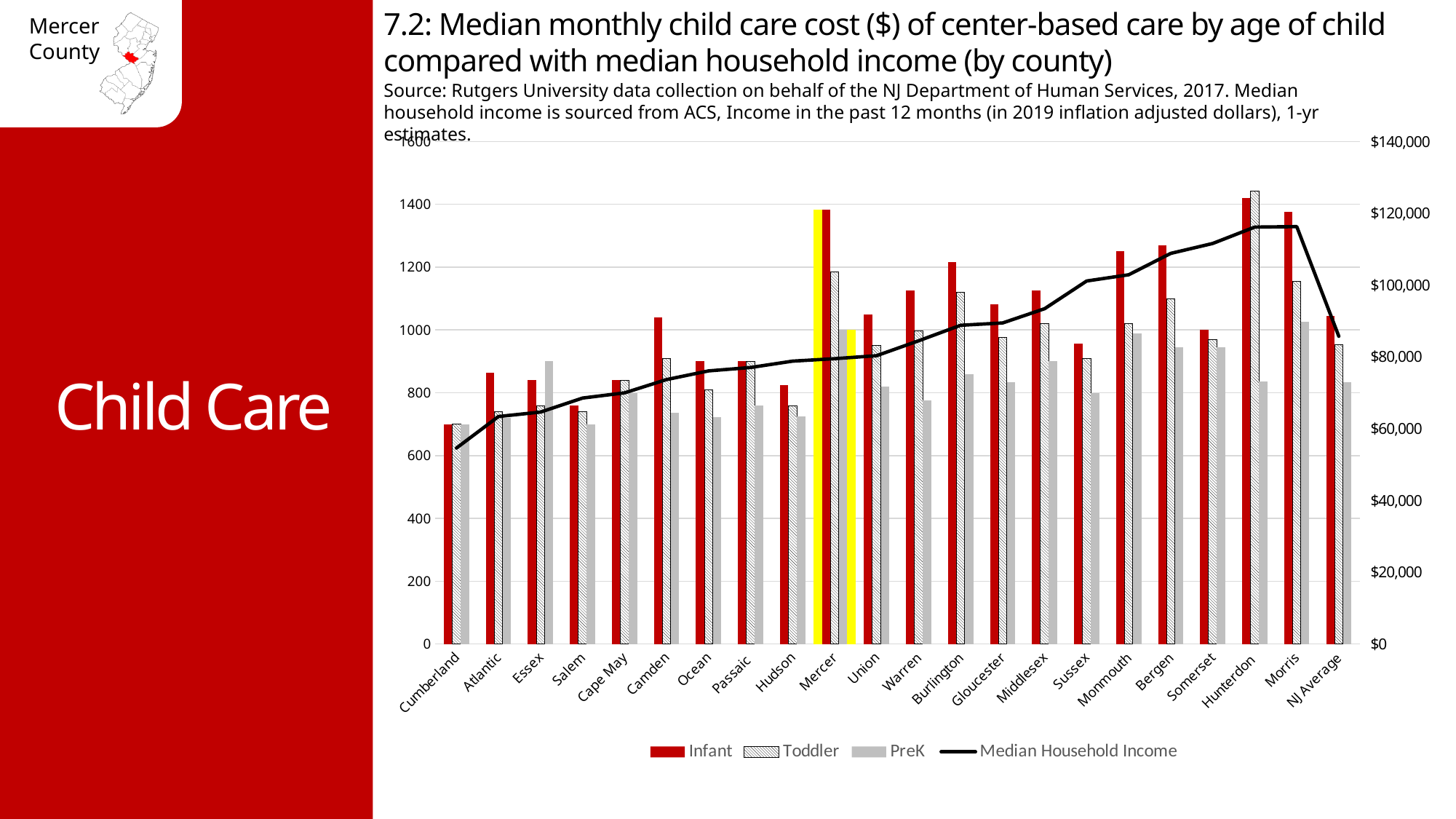
Which is larger, the Infant cost for Mercer or the Infant cost for Cumberland? Mercer Is the Infant cost for Mercer greater or less than 1200? greater Which county's bars are highlighted in yellow on the chart? Mercer Is the Infant cost for Cumberland greater or less than 800? less Which is larger for Hunterdon, the Toddler cost or the PreK cost? Toddler Is the Toddler cost for Hunterdon greater or less than 1200? greater How many series does the chart legend list? 4 Which county has the lowest Infant child care cost? Cumberland Which county has the highest Toddler child care cost? Hunterdon What kind of chart is used to show the child care costs by county? bar chart (with a line for median household income) How many counties/categories are shown on the x axis of the chart? 22 Does the Median Household Income line generally rise or fall from Cumberland to Morris? rise